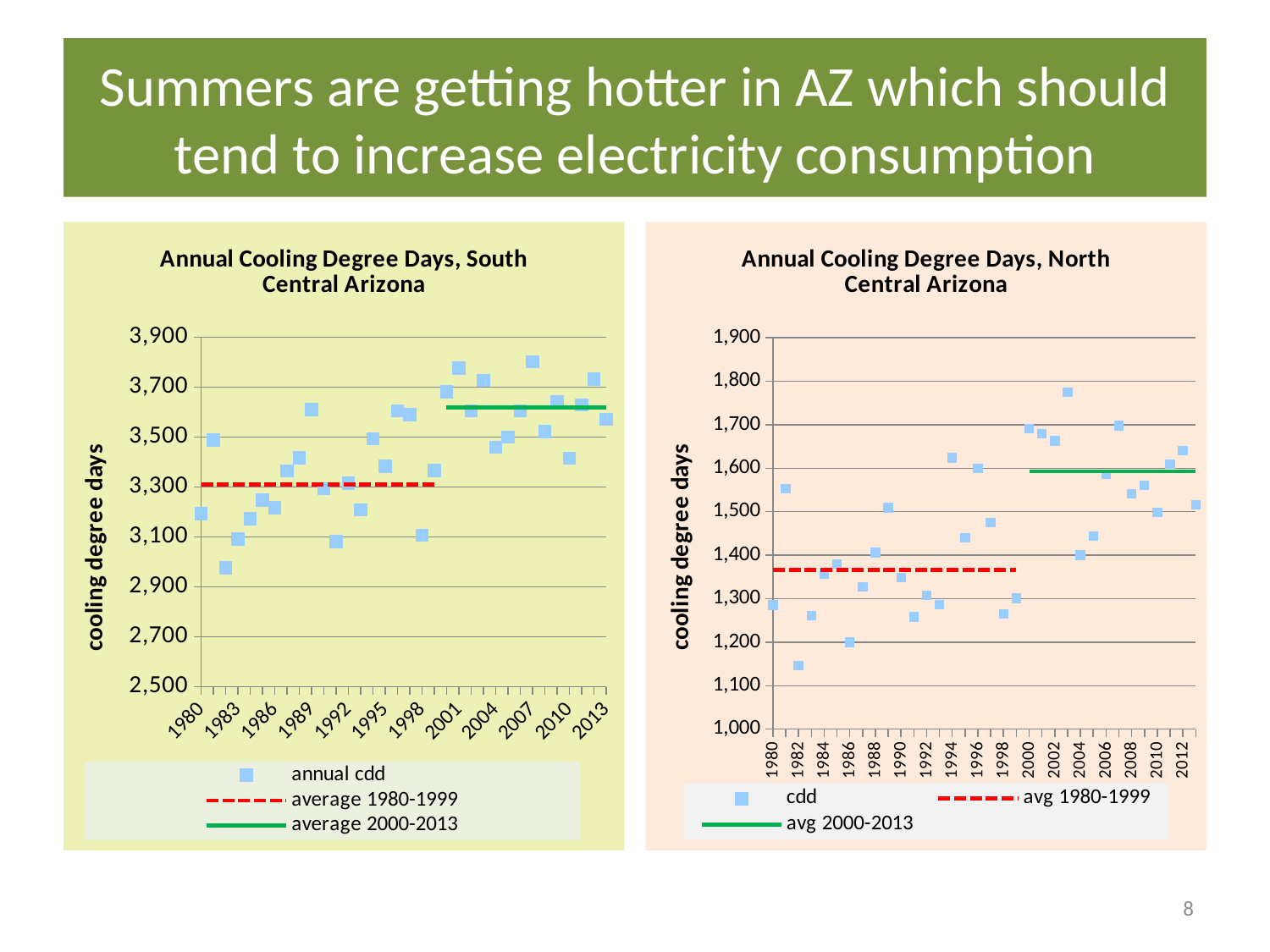
What kind of chart is the 'Annual Cooling Degree Days, South Central Arizona' chart? scatter chart Overall, do the annual cooling degree days in the 'Annual Cooling Degree Days, North Central Arizona' chart rise or fall from 1980 to 2013? rise In the 'Annual Cooling Degree Days, North Central Arizona' chart, which year has the highest cdd value? 2003 In the 'Annual Cooling Degree Days, South Central Arizona' chart, is the annual cdd value for 1982 greater or less than 3,100? less In the 'Annual Cooling Degree Days, North Central Arizona' chart, is the cdd value for 2003 greater or less than 1,700? greater In the 'Annual Cooling Degree Days, North Central Arizona' chart, which year has the lowest cdd value? 1982 In the 'Annual Cooling Degree Days, South Central Arizona' chart, is the annual cdd value for 2006 greater or less than 3,700? less In the 'Annual Cooling Degree Days, South Central Arizona' chart, which year has the lowest annual cdd value? 1982 How many series does the legend of the 'Annual Cooling Degree Days, North Central Arizona' chart list? 3 In the 'Annual Cooling Degree Days, South Central Arizona' chart, which is higher: the average 1980-1999 line or the average 2000-2013 line? average 2000-2013 What is the y-axis label of the 'Annual Cooling Degree Days, South Central Arizona' chart? cooling degree days